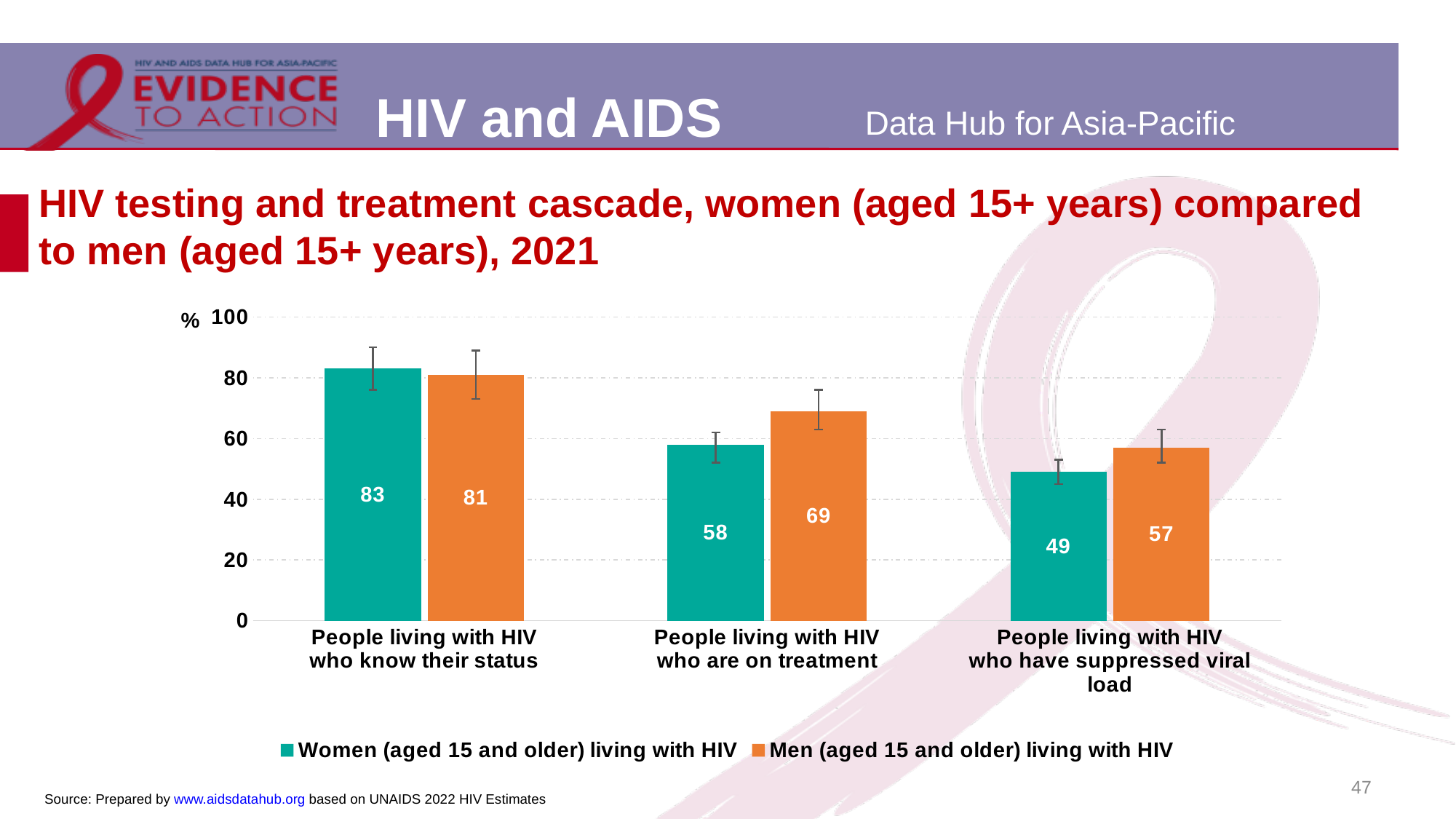
Which category has the lowest value for women (aged 15 and older) living with HIV? People living with HIV who have suppressed viral load Which category has the highest value for men (aged 15 and older) living with HIV? People living with HIV who know their status What is the value for women (aged 15 and older) living with HIV who have suppressed viral load? 49 How many series does the legend list? 2 What is the value for women (aged 15 and older) living with HIV who know their status? 83 What is the difference between men and women for people living with HIV who are on treatment? 11 How many categories are shown on the x axis? 3 Is the value for men (aged 15 and older) living with HIV who know their status greater or less than 60? greater For people living with HIV who have suppressed viral load, which is larger: the value for women or for men? Men What is the value for men (aged 15 and older) living with HIV who are on treatment? 69 Do the values for women (aged 15 and older) living with HIV rise or fall across the categories from left to right? Fall What kind of chart is shown on the slide? Bar chart